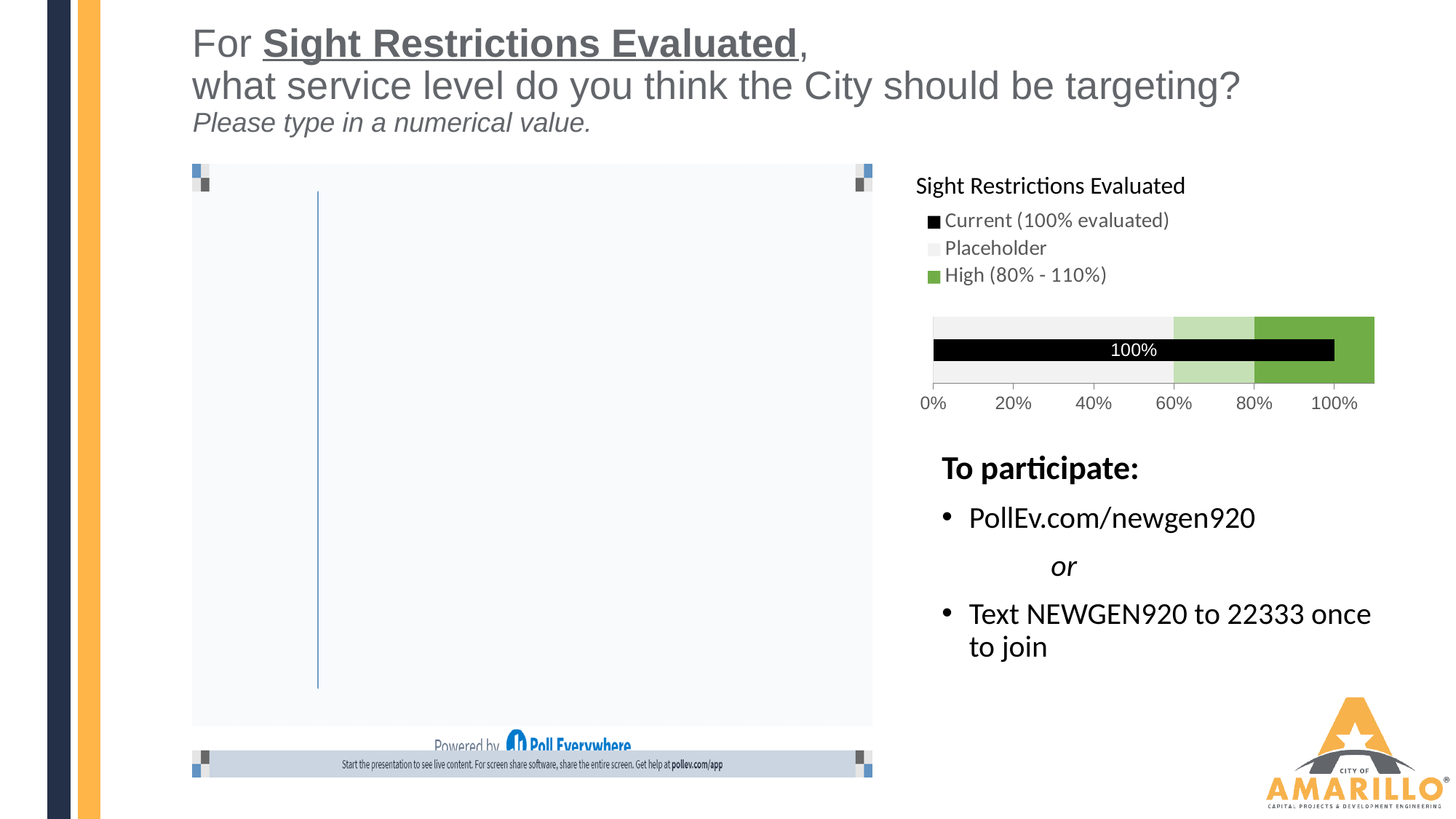
What is the highest tick label on the x axis of the Sight Restrictions Evaluated chart? 100% In the Sight Restrictions Evaluated chart, what value is printed on the black bar? 100% In the Sight Restrictions Evaluated chart, is the value of the Current bar greater or less than 60%? greater In the Sight Restrictions Evaluated chart, is the value of the Current bar greater or less than 80%? greater What is the title of the chart on the right side of the slide? Sight Restrictions Evaluated In the Sight Restrictions Evaluated chart, which legend entry is shown in black? Current (100% evaluated) How many entries does the legend of the Sight Restrictions Evaluated chart list? 3 What kind of chart is the Sight Restrictions Evaluated chart? bar chart In the Sight Restrictions Evaluated chart, what range is given in the legend for the High series? 80% - 110%